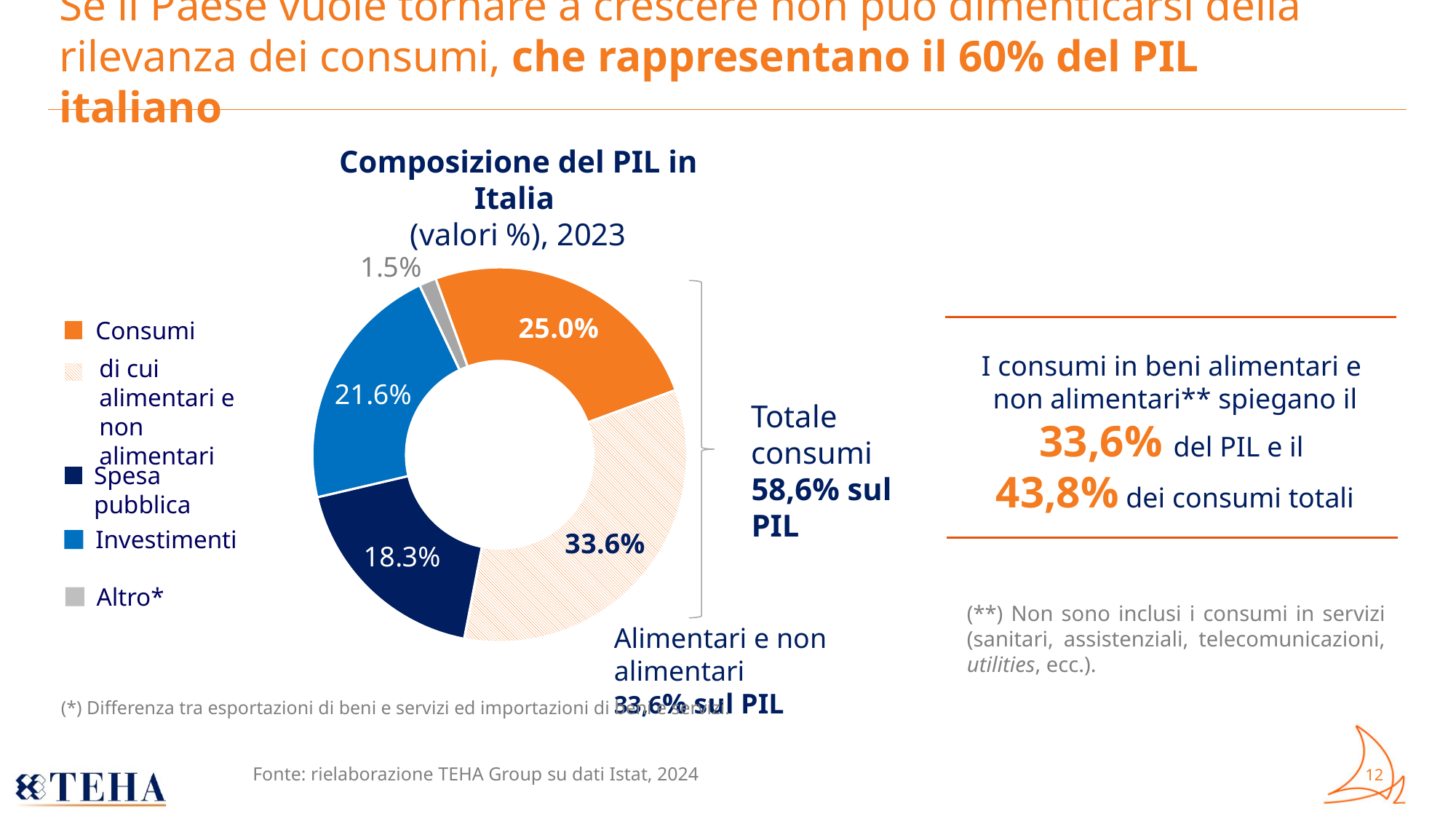
Which category has the largest share in the chart? di cui alimentari e non alimentari What is the value for Investimenti in the chart? 21.6% What is the title of the chart? Composizione del PIL in Italia (valori %), 2023 What is the value for Consumi in the chart? 25.0% What is the difference between the Investimenti and Spesa pubblica values? 3.3 percentage points Which is larger, the value for Consumi or the value for Investimenti? Consumi Which category has the smallest share in the chart? Altro* What is the value for Altro* in the chart? 1.5% How many categories does the legend of the chart list? 5 What is the value for Spesa pubblica in the chart? 18.3% What is the value for 'di cui alimentari e non alimentari' in the chart? 33.6% What kind of chart is shown on the slide? Donut (pie) chart